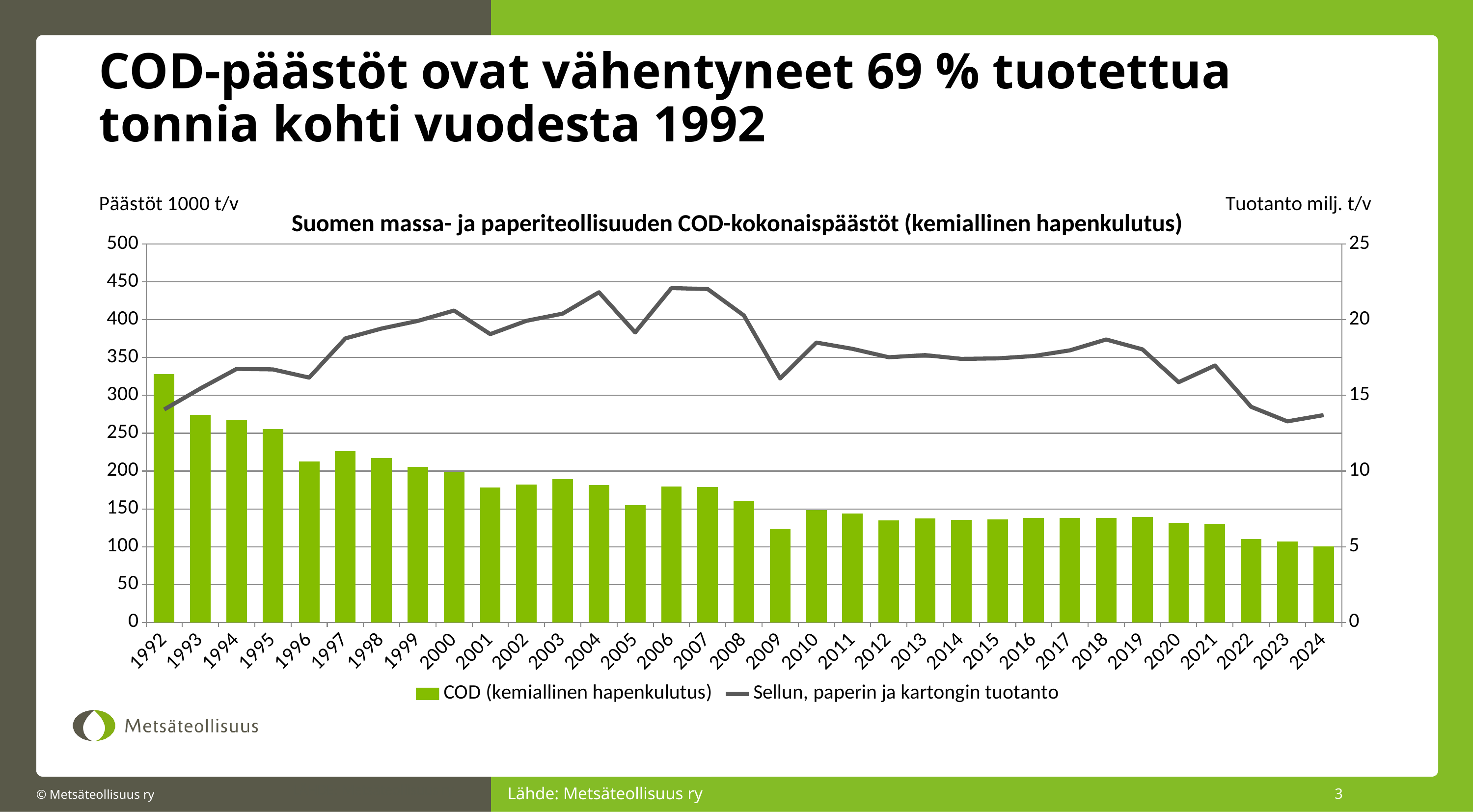
What is the title of the chart? Suomen massa- ja paperiteollisuuden COD-kokonaispäästöt (kemiallinen hapenkulutus) Do the COD (kemiallinen hapenkulutus) bars generally rise or fall from 1992 to 2024? fall Which year has the highest COD (kemiallinen hapenkulutus) bar? 1992 Is the Sellun, paperin ja kartongin tuotanto value for 2006 greater or less than 20 on the right axis? greater Is the COD value for 1992 greater or less than 300? greater Is the COD value for 1996 greater or less than 200? greater How many years are shown on the x axis? 33 What kind of chart is shown on the slide? A combined bar and line chart How many series does the legend list? 2 Which year has the lowest COD (kemiallinen hapenkulutus) bar? 2024